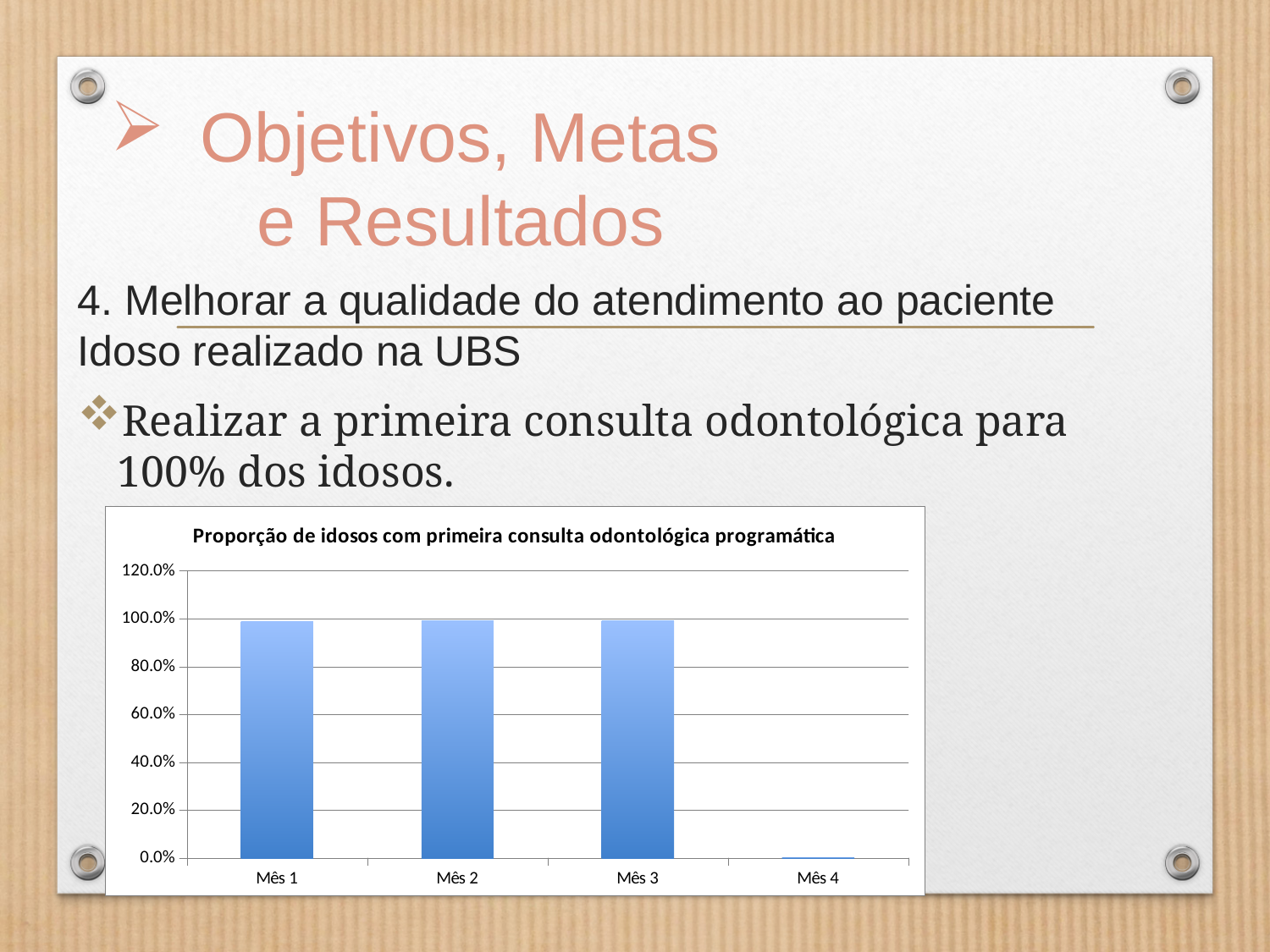
Does the value fall or rise from Mês 3 to Mês 4? fall Is the value for Mês 1 greater or less than 80.0%? greater Is the value for Mês 4 greater or less than 20.0%? less What is the highest value shown on the y axis of the chart? 120.0% What is the title of the chart? Proporção de idosos com primeira consulta odontológica programática Which is larger, the value for Mês 4 or the value for Mês 1? Mês 1 Which is larger, the value for Mês 2 or the value for Mês 4? Mês 2 What kind of chart is shown on the slide? bar chart Which month has the lowest value in the chart? Mês 4 Is the value for Mês 3 greater or less than 60.0%? greater How many categories (months) are shown on the x axis of the chart? 4